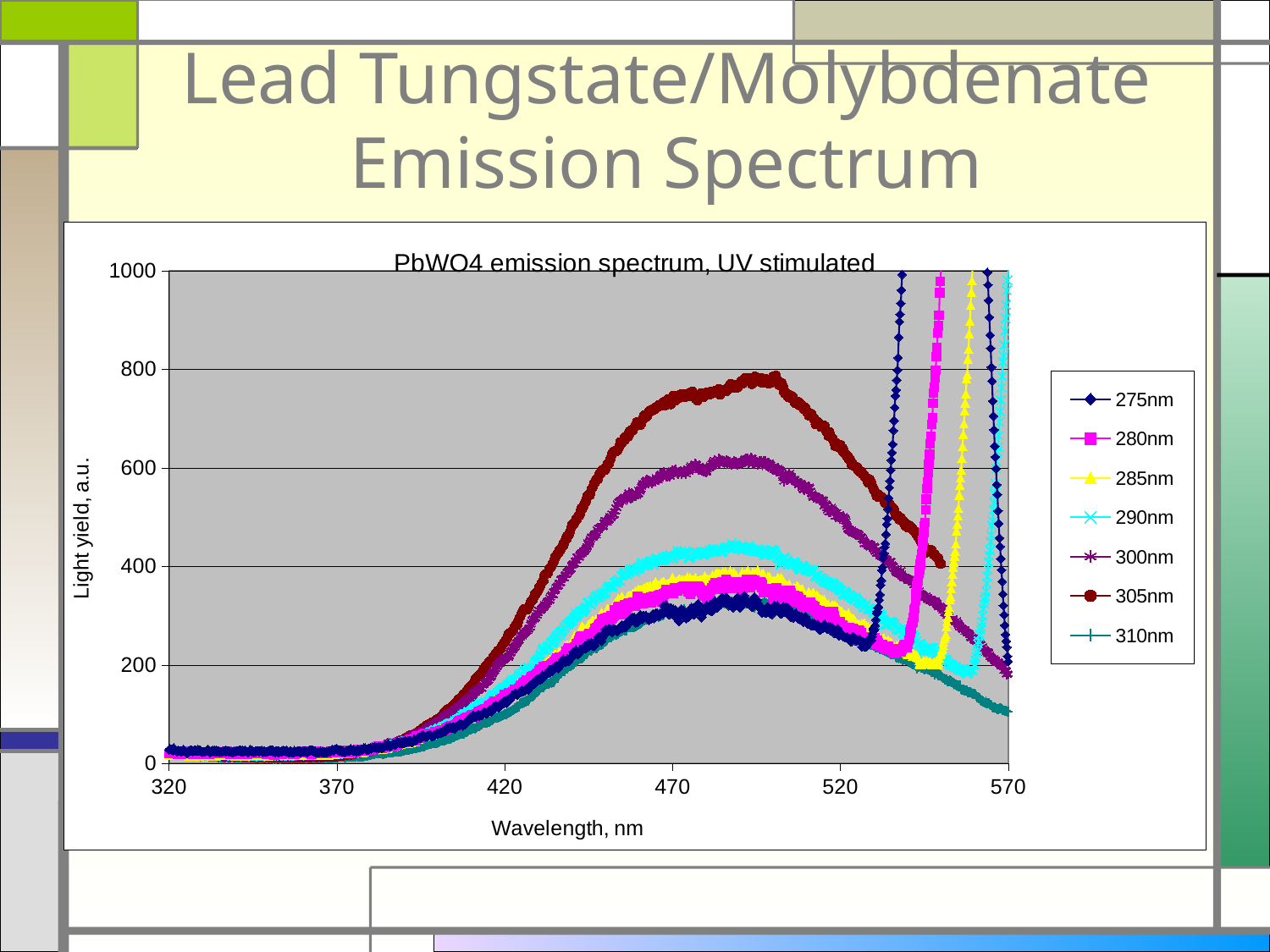
Around 490 nm, which series has the larger light yield, 305nm or 300nm? 305nm What is the title of the chart? PbWO4 emission spectrum, UV stimulated What is the label of the x axis? Wavelength, nm Around 490 nm, which series has the larger light yield, 290nm or 275nm? 290nm Between 320 nm and 370 nm, is the light yield for the 305nm series greater or less than 200? less What kind of chart is shown on the slide? line chart Is the peak value of the 300nm series greater or less than 400? greater Is the peak value of the 305nm series greater or less than 600? greater How many series does the legend list? 7 Which series reaches the highest peak light yield in the 450–520 nm region? 305nm